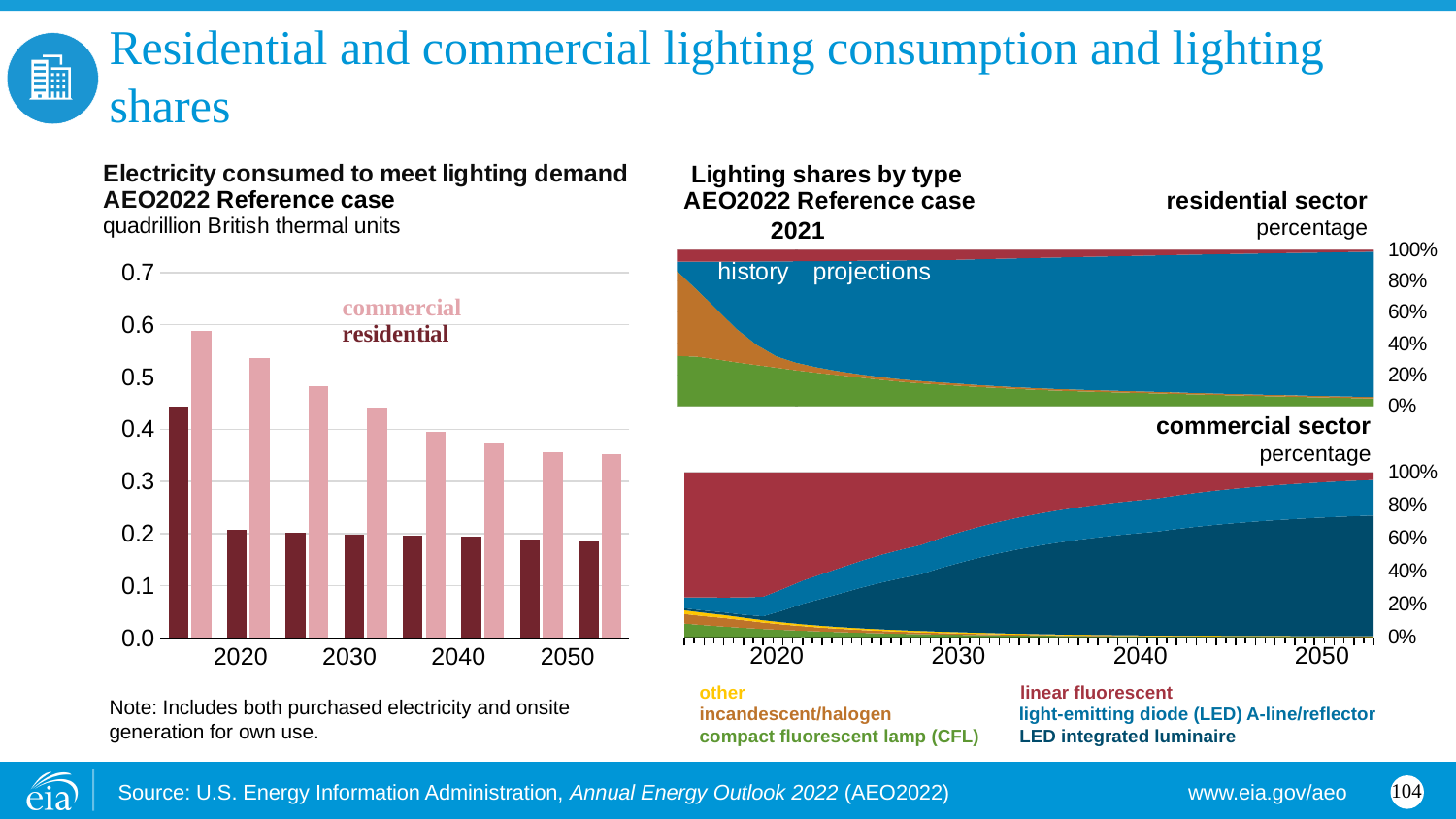
How many lighting types does the legend list for the 'Lighting shares by type' charts? 6 In the 'Electricity consumed to meet lighting demand' chart, is the residential value for 2020 greater or less than 0.3? less In the commercial sector 'Lighting shares by type' chart, is the share of LED integrated luminaire in 2050 greater or less than 60%? greater In the 'Electricity consumed to meet lighting demand' chart, is the commercial value for 2050 greater or less than 0.4? less What unit is used on the 'Electricity consumed to meet lighting demand' chart? quadrillion British thermal units In the 'Electricity consumed to meet lighting demand' chart, do the commercial values rise or fall from 2020 to 2050? fall How many series does the 'Electricity consumed to meet lighting demand' chart show? 2 In the 'Electricity consumed to meet lighting demand' chart, which is larger in 2020, commercial or residential? commercial What kind of chart is the 'Electricity consumed to meet lighting demand' chart on the left? bar chart